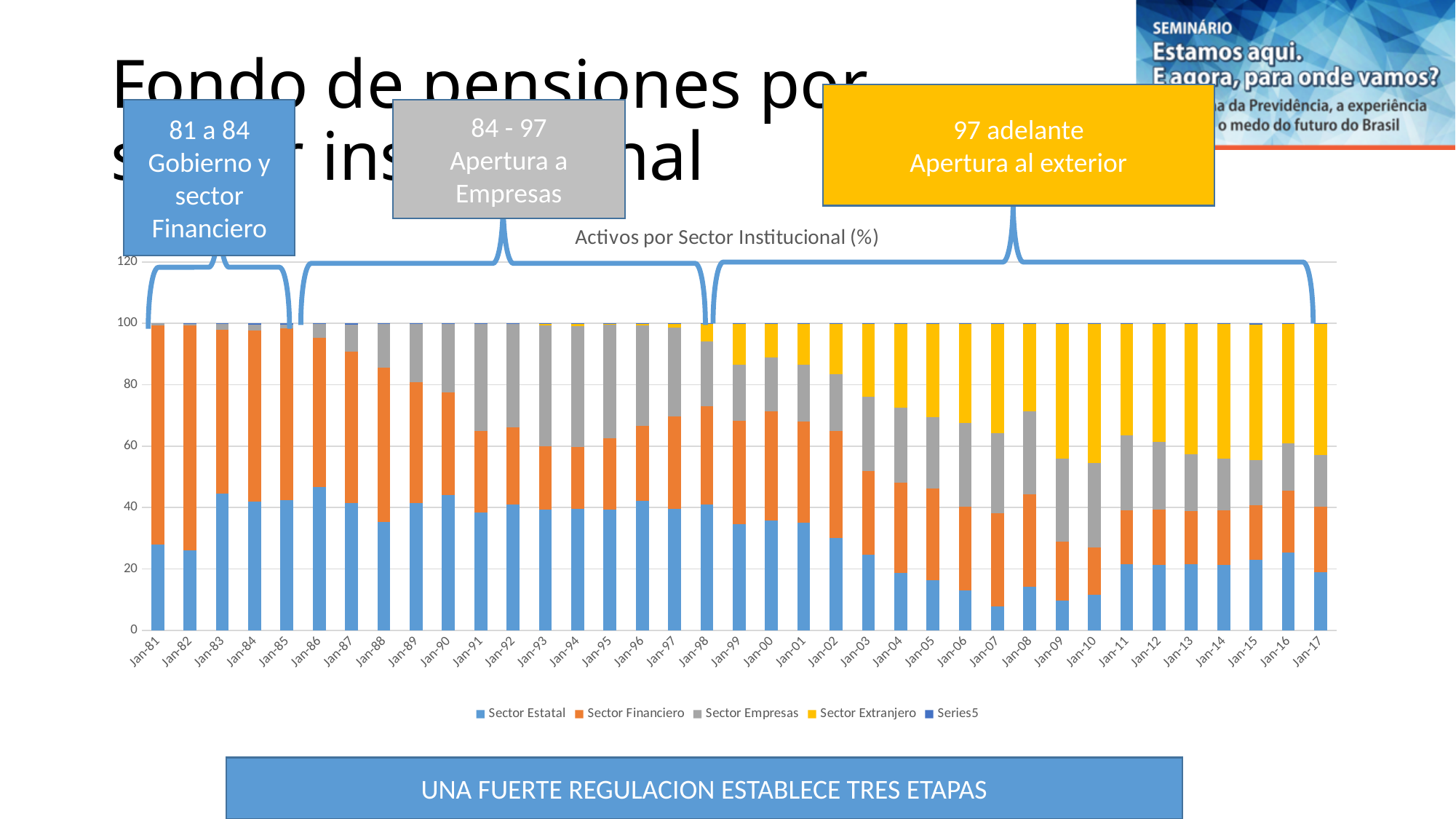
What is the title of the chart? Activos por Sector Institucional (%) Is the Sector Estatal value for Jan-07 greater or less than 20? less Is the Sector Estatal value for Jan-86 greater or less than 40? greater Does the Sector Financiero share generally rise or fall from Jan-81 to Jan-98? fall Is the Sector Estatal value for Jan-81 greater or less than 40? less How many series does the chart legend list? 5 How many time points (categories) are plotted along the x axis? 37 Which series is shown in yellow in the chart? Sector Extranjero Which has the larger Sector Estatal value, Jan-86 or Jan-07? Jan-86 What kind of chart is shown on the slide? Stacked bar chart Which has the larger Sector Estatal value, Jan-81 or Jan-83? Jan-83 Does the Sector Extranjero share generally rise or fall from Jan-99 to Jan-17? rise